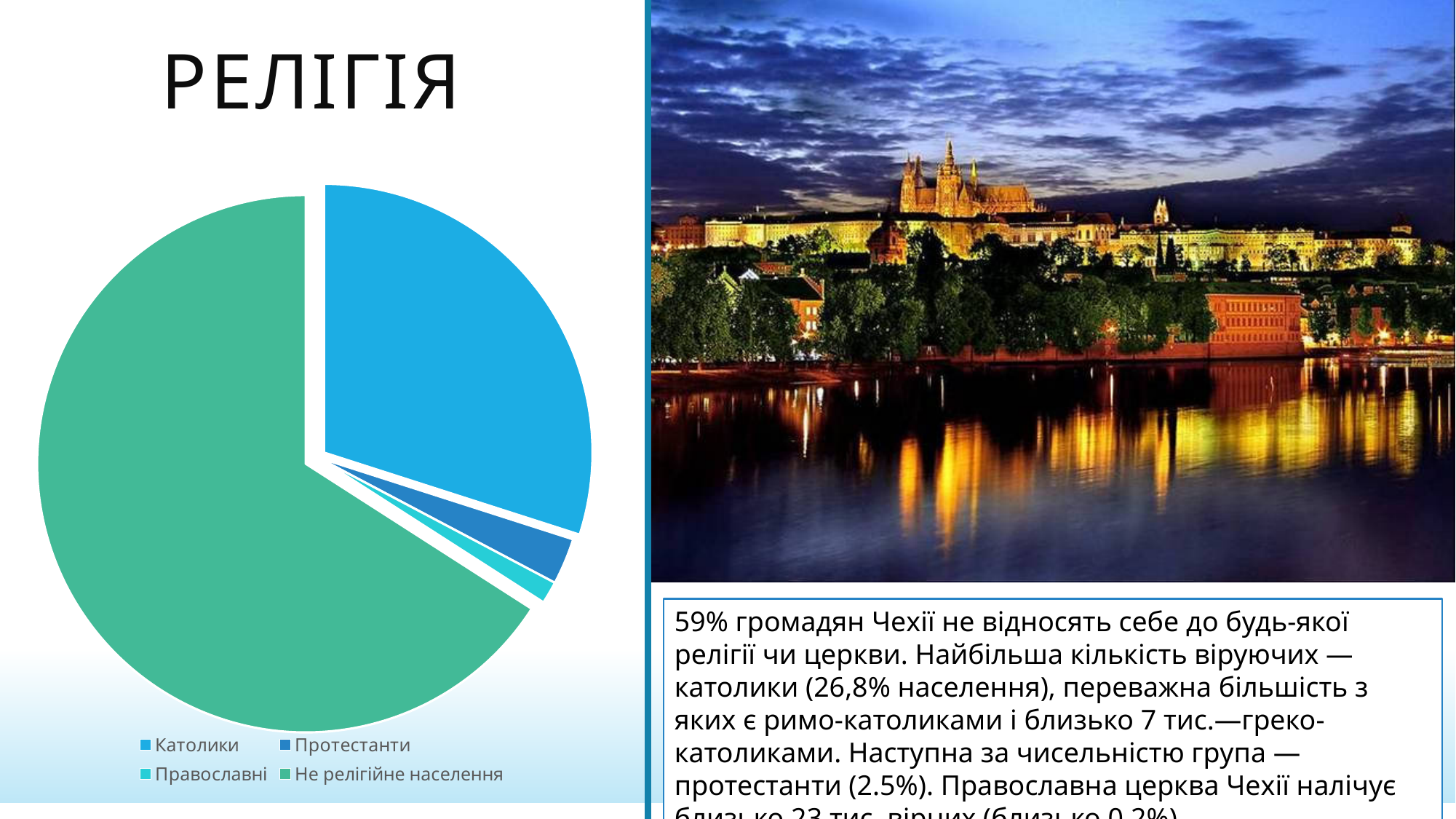
What kind of chart is shown on the slide? pie chart How many categories does the legend of the pie chart list? 4 Which legend entry is shown in green in the pie chart? Не релігійне населення Which slice is larger in the pie chart: Не релігійне населення or Католики? Не релігійне населення Which slice is larger in the pie chart: Католики or Протестанти? Католики Which category has the smallest slice in the pie chart? Православні Which category is the second-largest slice in the pie chart? Католики Which slice is larger in the pie chart: Протестанти or Православні? Протестанти Which category has the largest slice in the pie chart? Не релігійне населення What is the title of the slide containing the pie chart? РЕЛІГІЯ